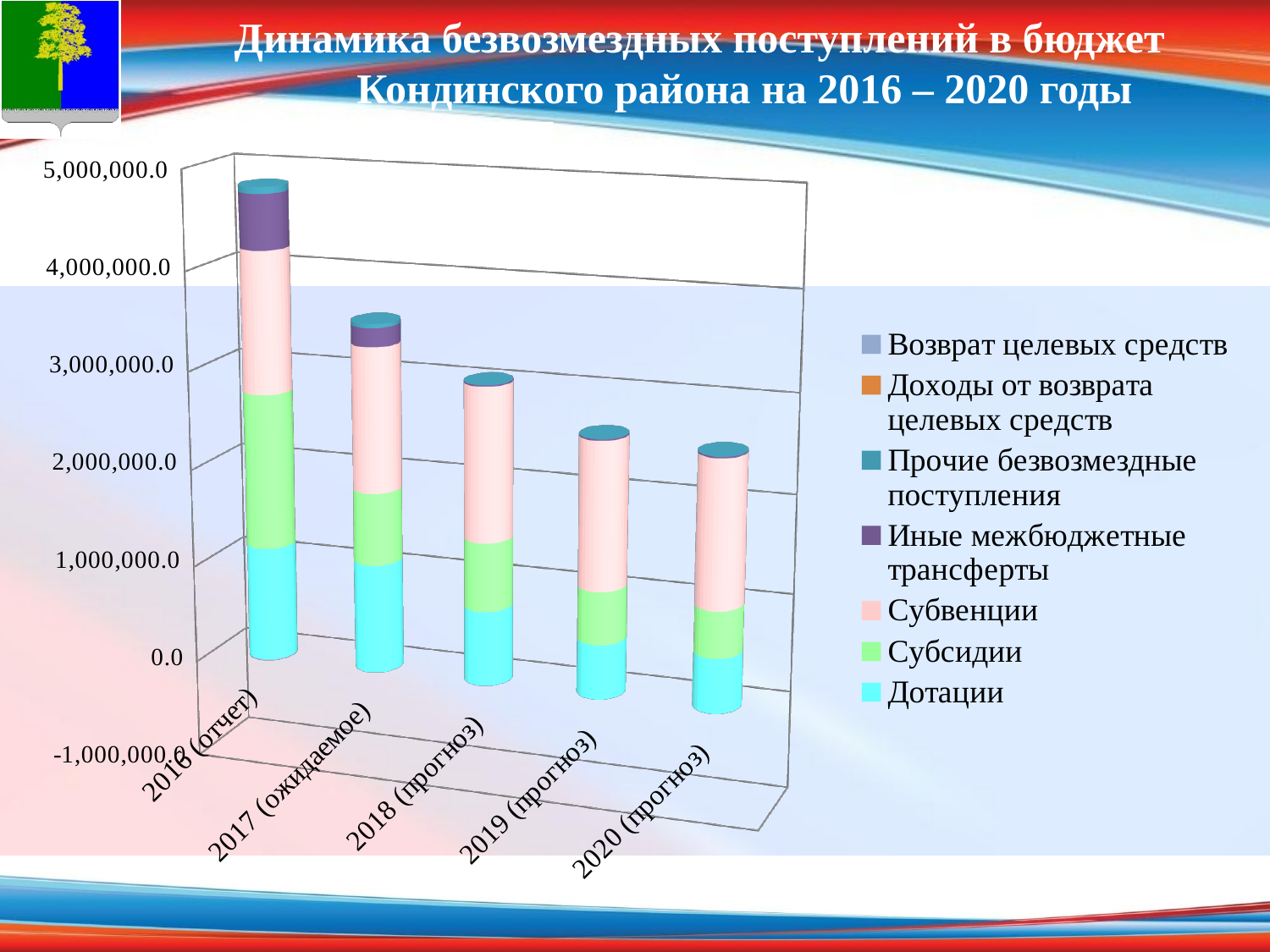
Do the total bar heights rise or fall from 2016 to 2020? Fall How many year categories are shown on the x axis of the chart? 5 How many series does the chart legend list? 7 Which total bar is larger: 2016 (отчет) or 2020 (прогноз)? 2016 (отчет) Is the total value for 2016 (отчет) greater or less than 4,000,000.0? greater Which year has the larger Субсидии segment: 2016 (отчет) or 2020 (прогноз)? 2016 (отчет) Which legend entry is shown at the bottom of the legend? Дотации Which year has the highest total bar in the chart? 2016 (отчет) Is the total value for 2017 (ожидаемое) greater or less than 3,000,000.0? greater What kind of chart is shown on the slide? Stacked bar chart What is the title of the chart on the slide? Динамика безвозмездных поступлений в бюджет Кондинского района на 2016 – 2020 годы Is the total value for 2020 (прогноз) greater or less than 3,000,000.0? less